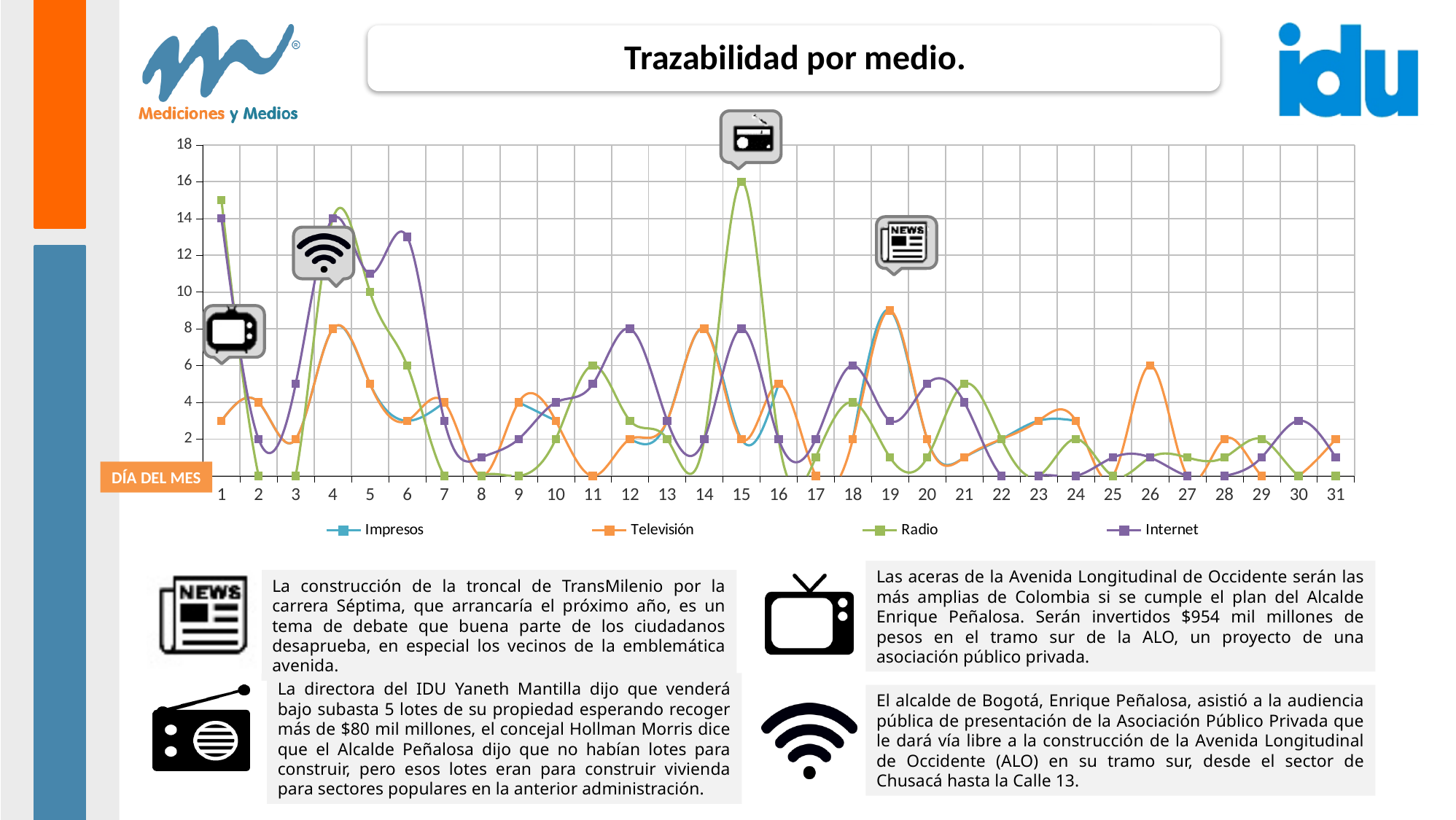
What is the value of the Televisión series on day 26? 6 What is the value of the Radio series on day 15? 16 What kind of chart is shown on the slide? line chart What is the value of the Televisión series on day 4? 8 How many series does the legend list? 4 How many days of the month are plotted along the x axis? 31 On day 15, which series has the larger value, Radio or Internet? Radio What is the difference between the Radio value and the Internet value on day 15? 8 On which day does the Radio series reach its highest value? 15 What is the title of the chart? Trazabilidad por medio. What is the value of the Internet series on day 1? 14 Is the value for Radio on day 1 greater or less than 14? greater